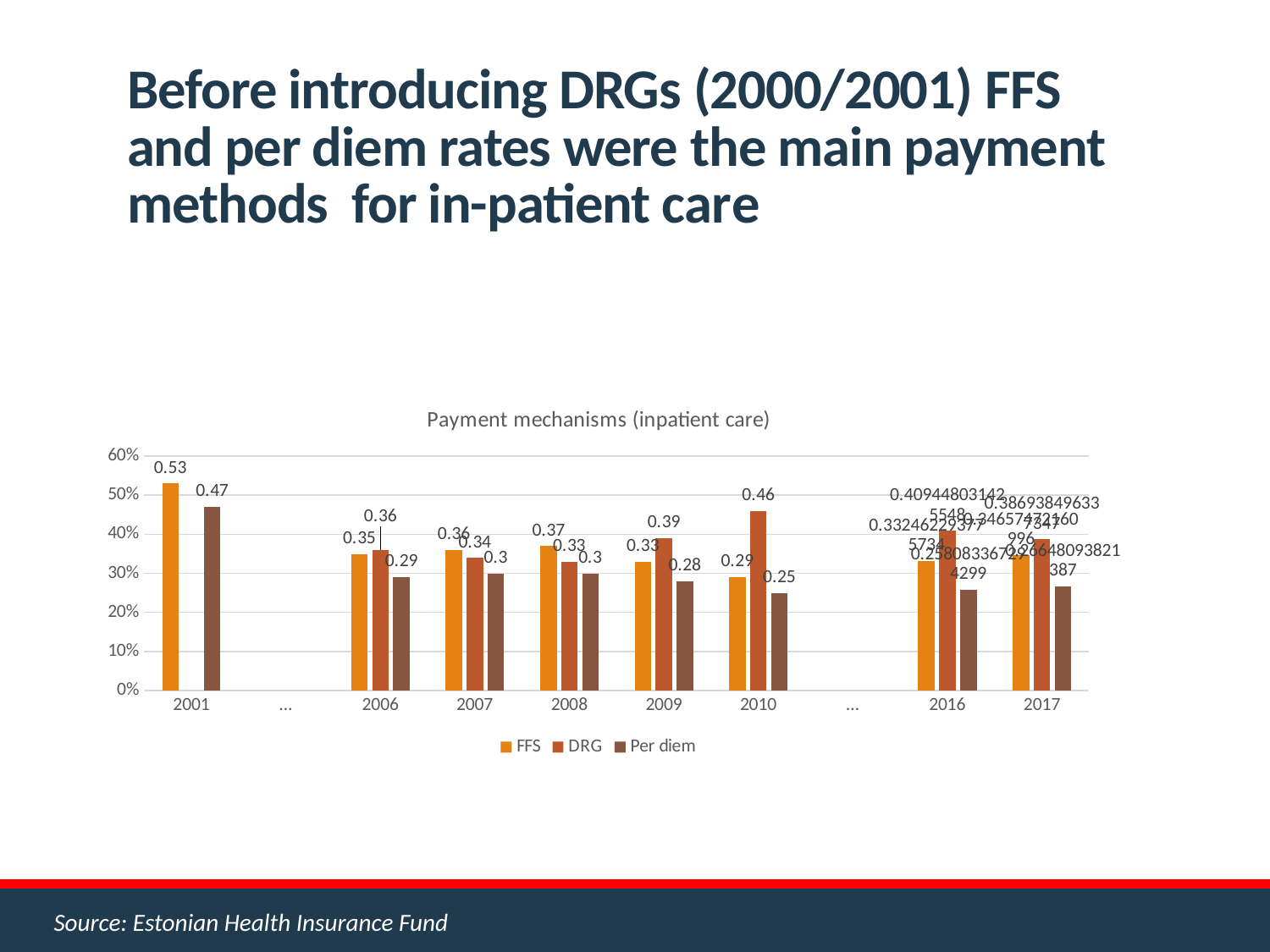
Is the Per diem value for 2016 greater or less than 30%? less What is the Per diem value for 2009? 0.28 What is the Per diem value for 2001? 0.47 How many series does the legend list? 3 Does the FFS value rise or fall from 2008 to 2010? fall What is the DRG value for 2010? 0.46 Among the years with readable labels, in which year is the DRG value highest? 2010 Among the years with readable labels, in which year is the Per diem value lowest? 2010 What kind of chart is shown on the slide? bar chart In 2009, which is larger, the FFS value or the DRG value? DRG What is the FFS value for 2001 in the Payment mechanisms (inpatient care) chart? 0.53 What is the difference between the FFS and Per diem values in 2001? 0.06